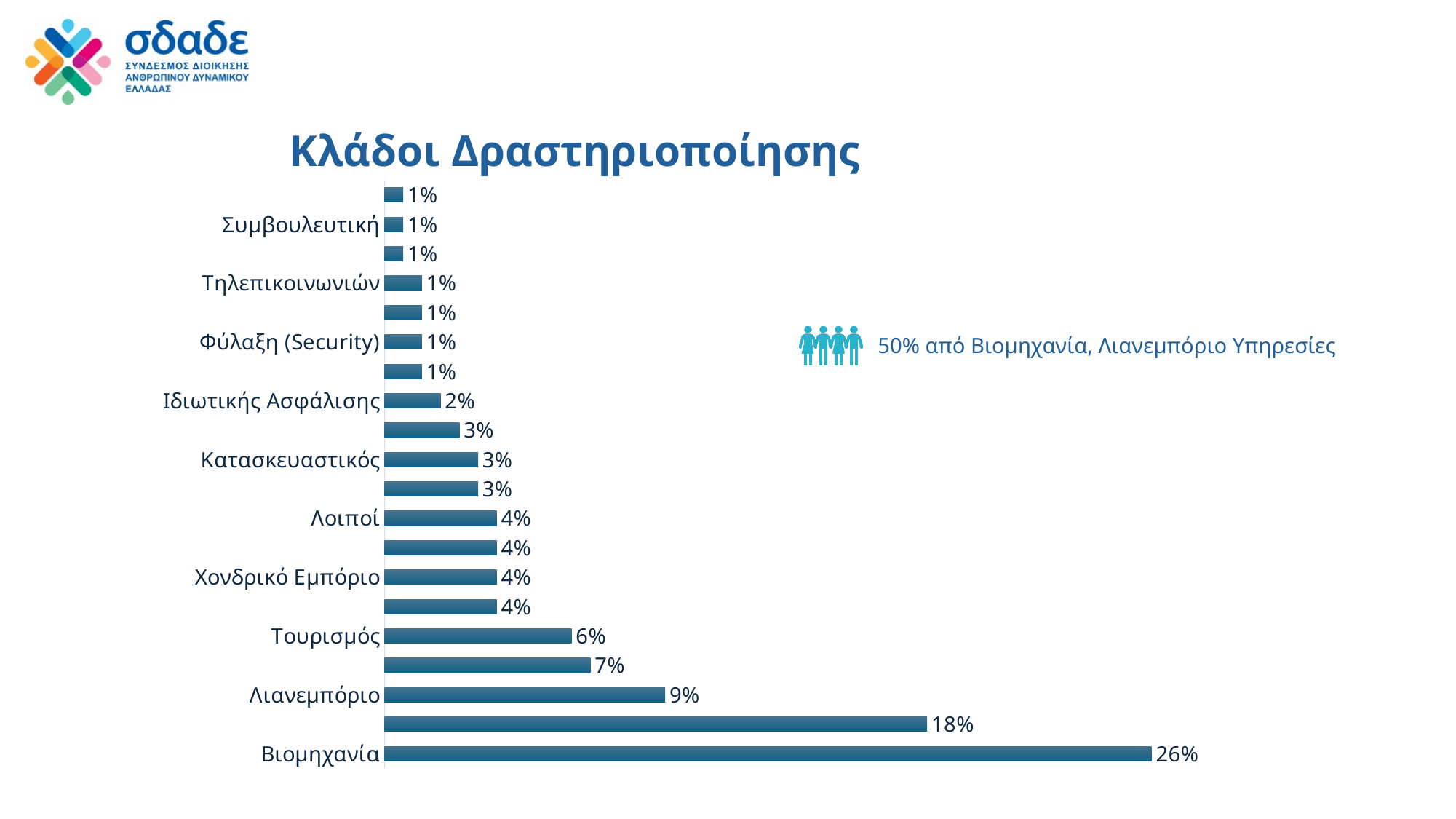
What is the value for Ιδιωτικής Ασφάλισης? 2% What is the value for Κατασκευαστικός? 3% What is the value for Χονδρικό Εμπόριο? 4% How many bars are plotted in the chart? 20 What is the value for Βιομηχανία? 26% What is the value for Λιανεμπόριο? 9% What is the title of the chart? Κλάδοι Δραστηριοποίησης What kind of chart is shown on the slide? Bar chart Which is larger, the value for Τουρισμός or the value for Λοιποί? Τουρισμός Which category has the highest value? Βιομηχανία What is the difference between the values for Βιομηχανία and Λιανεμπόριο? 17 percentage points What is the value for Τουρισμός? 6%